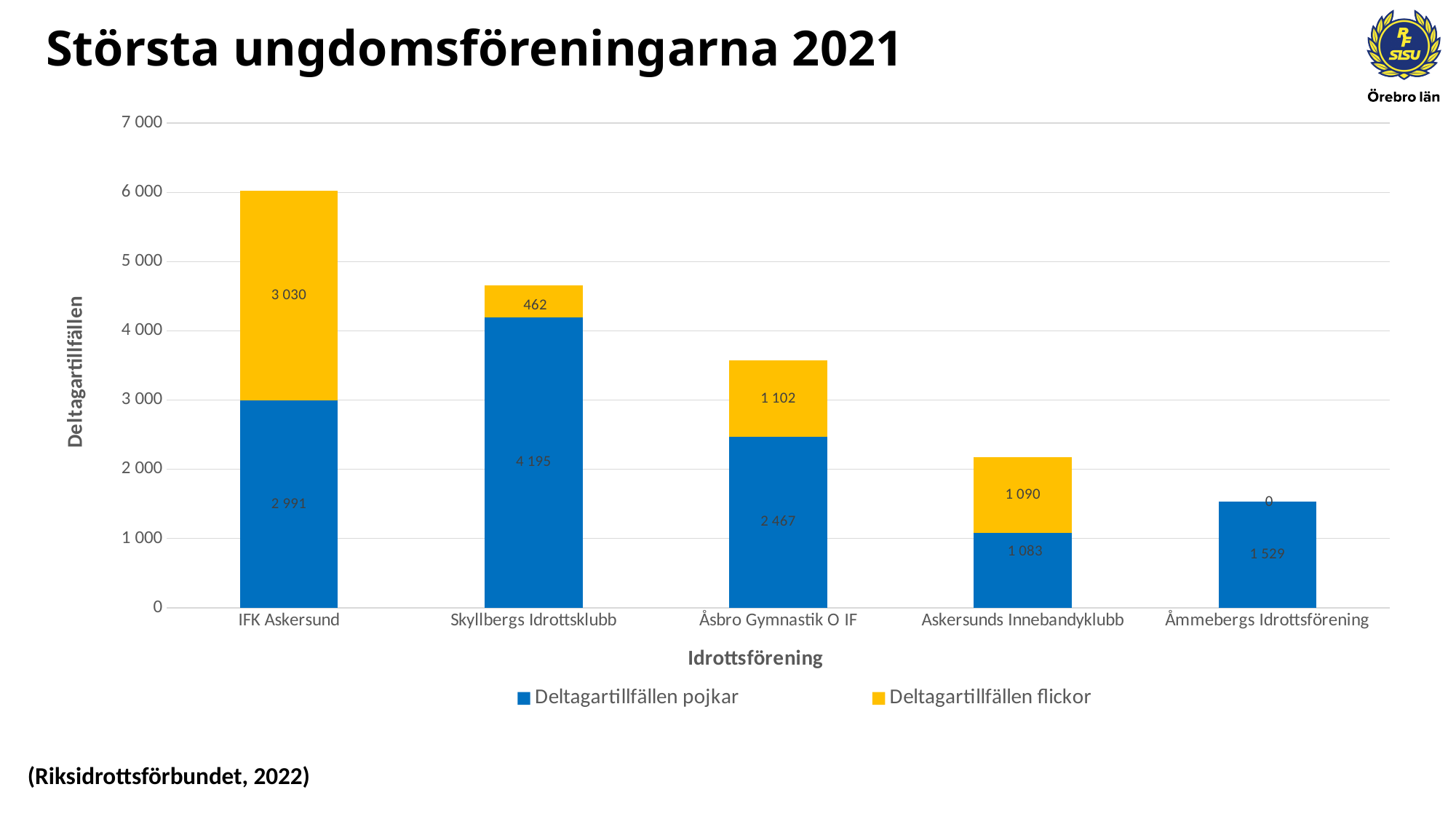
Which idrottsförening has the lowest value for Deltagartillfällen flickor? Åmmebergs Idrottsförening What kind of chart is shown on the slide? Stacked bar chart Which is larger for Askersunds Innebandyklubb: Deltagartillfällen pojkar or Deltagartillfällen flickor? Deltagartillfällen flickor How many idrottsföreningar (categories) are shown on the x axis? 5 Which idrottsförening has the highest value for Deltagartillfällen pojkar? Skyllbergs Idrottsklubb What is the value of Deltagartillfällen pojkar for Skyllbergs Idrottsklubb? 4 195 How many series does the legend list? 2 What is the title of the chart? Största ungdomsföreningarna 2021 What is the value of Deltagartillfällen flickor for IFK Askersund? 3 030 What is the difference between Deltagartillfällen pojkar and Deltagartillfällen flickor for Åsbro Gymnastik O IF? 1 365 What is the total of the stacked bar for IFK Askersund? 6 021 What is the value of Deltagartillfällen flickor for Åmmebergs Idrottsförening? 0